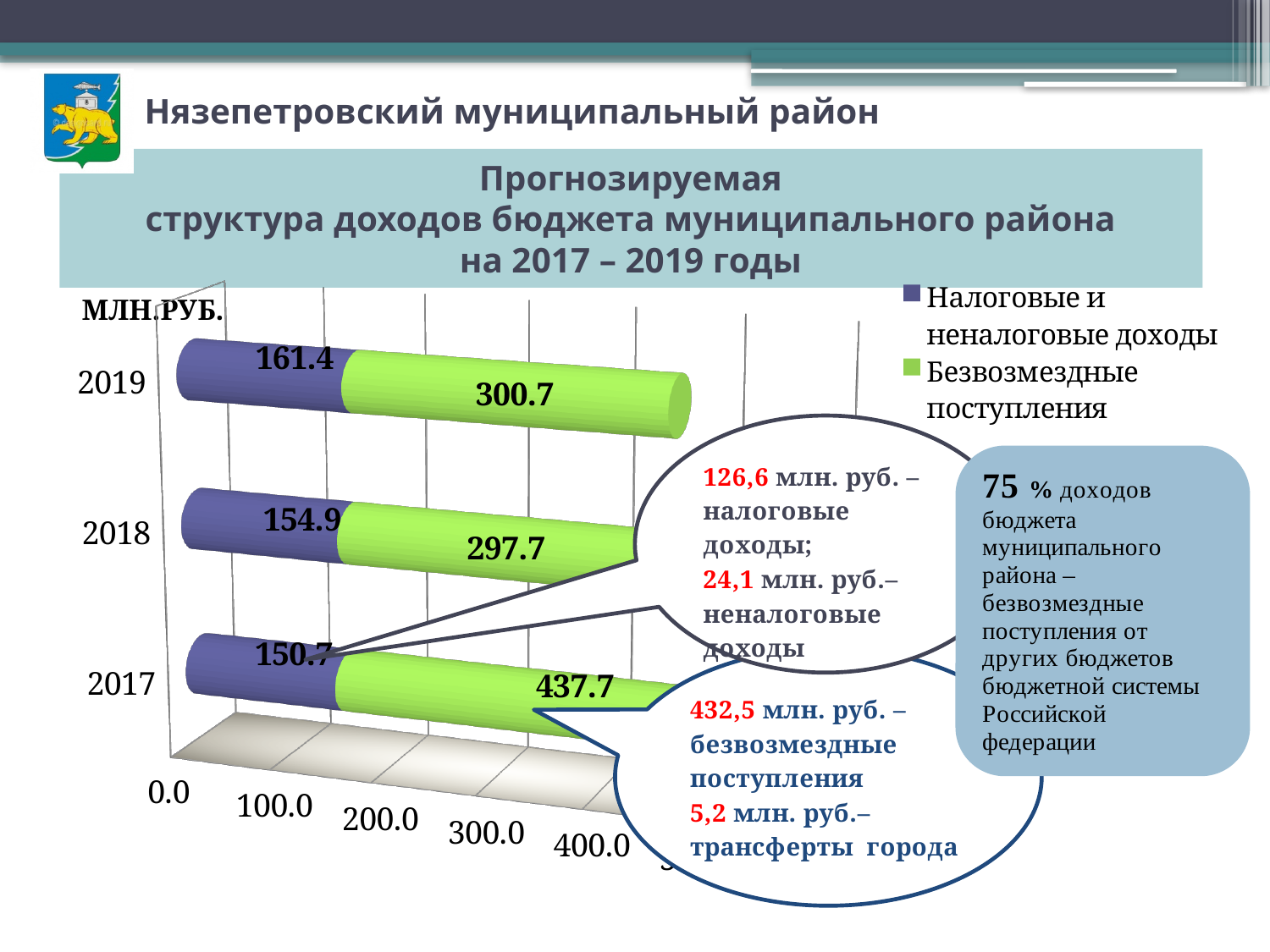
Which year has the lowest value for Налоговые и неналоговые доходы? 2017 What is the value of Безвозмездные поступления for 2017? 437.7 What is the total of the stacked bar for 2019? 462.1 Which year has the highest value for Безвозмездные поступления? 2017 What is the value of Безвозмездные поступления for 2018? 297.7 How many years are shown on the chart? 3 Which is larger: Налоговые и неналоговые доходы in 2018 or in 2019? 2019 What is the value of Налоговые и неналоговые доходы for 2017? 150.7 What is the difference between Безвозмездные поступления in 2017 and 2019? 137.0 What is the value of Налоговые и неналоговые доходы for 2019? 161.4 What kind of chart is shown on the slide? Stacked bar chart How many series does the legend list? 2